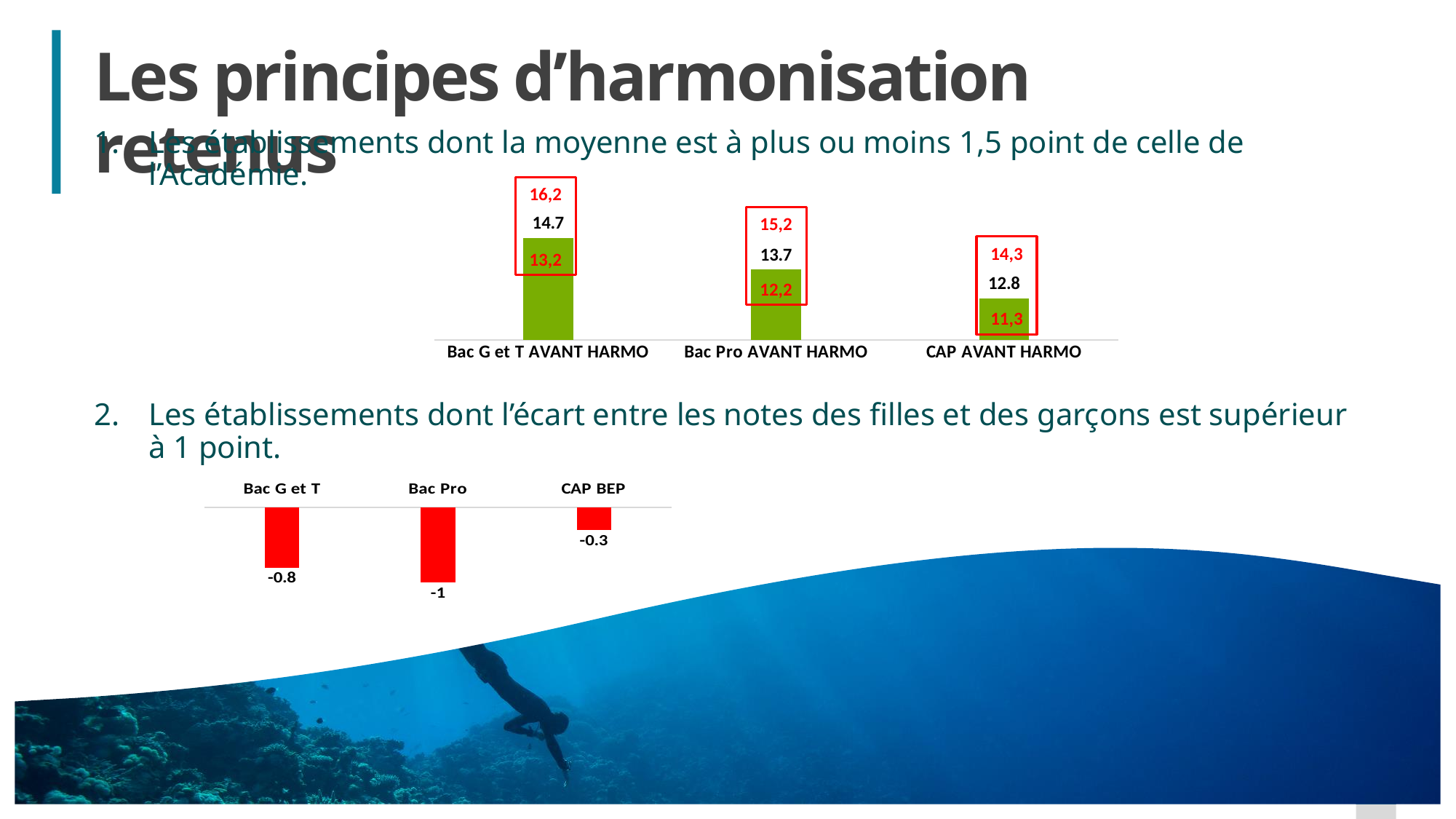
In the top chart, what is the value for CAP AVANT HARMO? 12.8 In the top chart, what is the value for Bac G et T AVANT HARMO? 14.7 What type of chart is the bottom chart? bar chart In the bottom chart, what is the value for CAP BEP? -0.3 In the top chart, which category has the lowest value? CAP AVANT HARMO In the bottom chart, which category has the lowest value? Bac Pro In the bottom chart, what is the value for Bac Pro? -1 In the bottom chart, is the value for Bac G et T larger or smaller than the value for CAP BEP? smaller In the top chart, how many categories are shown? 3 In the top chart, which category has the highest value? Bac G et T AVANT HARMO In the top chart, what is the value for Bac Pro AVANT HARMO? 13.7 In the top chart, what is the difference between the values for Bac G et T AVANT HARMO and CAP AVANT HARMO? 1.9